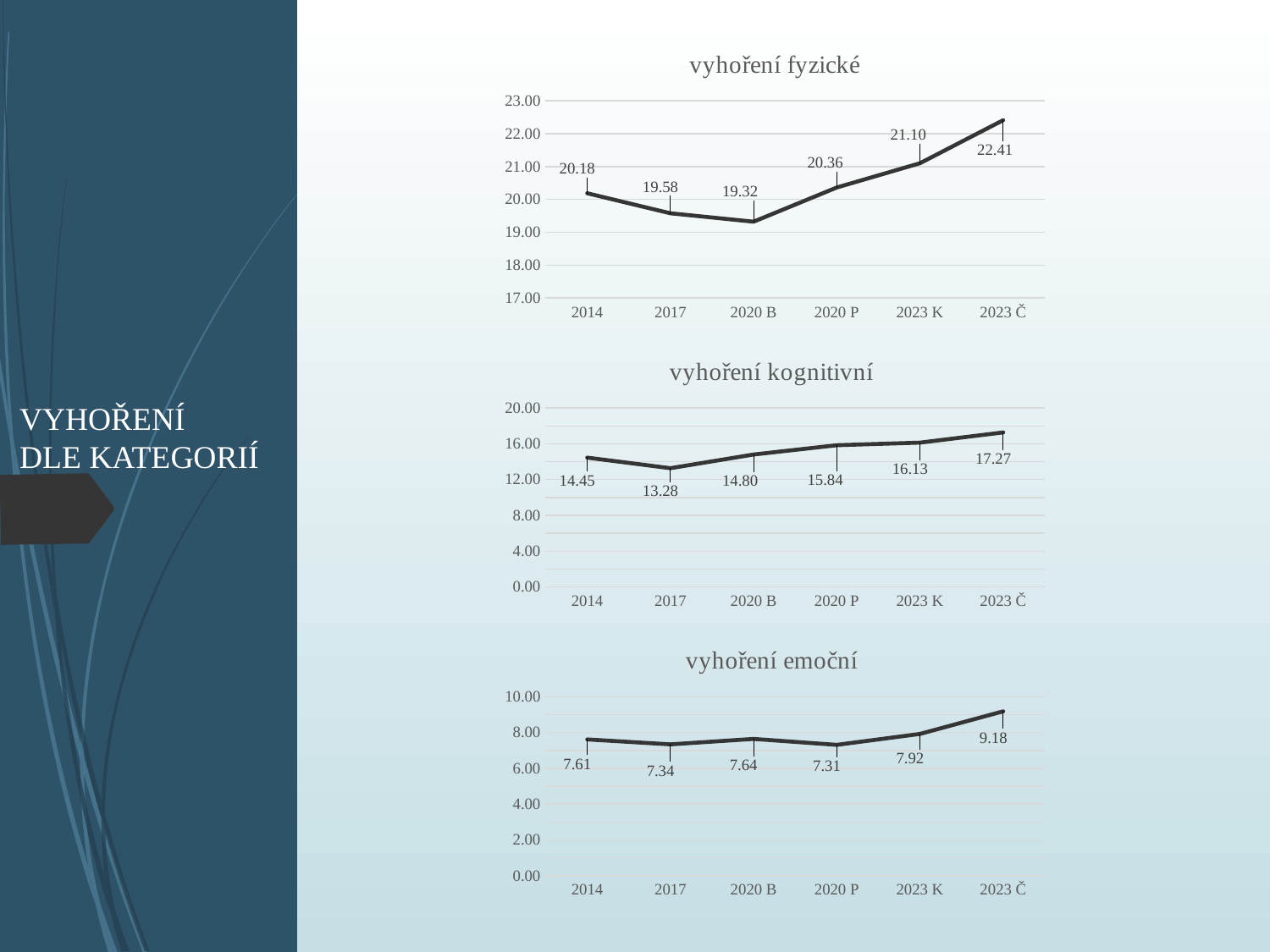
In the 'vyhoření fyzické' chart, which category has the lowest value? 2020 B How many categories are shown on the x axis of the 'vyhoření emoční' chart? 6 In the 'vyhoření kognitivní' chart, which category has the highest value? 2023 Č In the 'vyhoření kognitivní' chart, is the value for 2017 greater or less than 12.00? greater In the 'vyhoření kognitivní' chart, what is the value for 2020 P? 15.84 In the 'vyhoření emoční' chart, what is the difference between the values for 2023 Č and 2020 P? 1.87 In the 'vyhoření fyzické' chart, do the values rise or fall from 2020 B to 2023 Č? rise In the 'vyhoření fyzické' chart, what is the value for 2014? 20.18 In the 'vyhoření fyzické' chart, what is the difference between the values for 2023 Č and 2014? 2.23 In the 'vyhoření emoční' chart, what is the value for 2023 K? 7.92 In the 'vyhoření emoční' chart, which is larger, the value for 2017 or the value for 2020 B? 2020 B What kind of chart is the 'vyhoření fyzické' chart? line chart